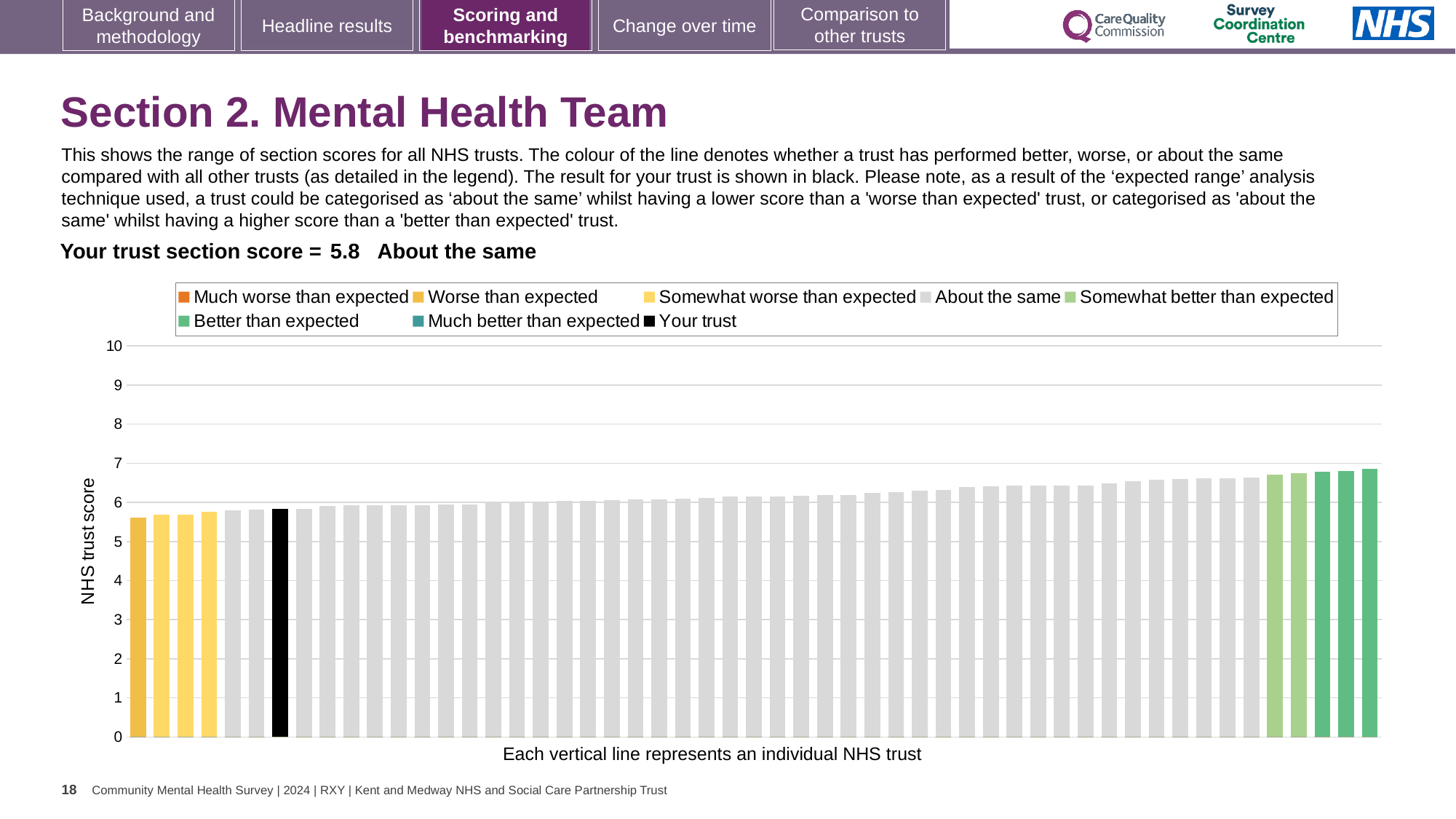
What kind of chart is shown on the slide? bar chart How many bars are shown in the 'Somewhat worse than expected' colour? 3 What is your trust's section score for Mental Health Team as printed on the slide? 5.8 Do the bar values rise or fall from left to right along the x axis? rise Is your trust's bar higher or lower than the leftmost bar in the chart? higher Is the value of your trust's bar greater or less than 6? less Is the value of the tallest bar greater or less than 7? less How many entries does the chart legend list? 8 Which performance category is your trust placed in for this section? About the same Is the value of the shortest bar greater or less than 5? greater What is the label on the vertical axis of the chart? NHS trust score What colour is used for the bar representing your trust? black